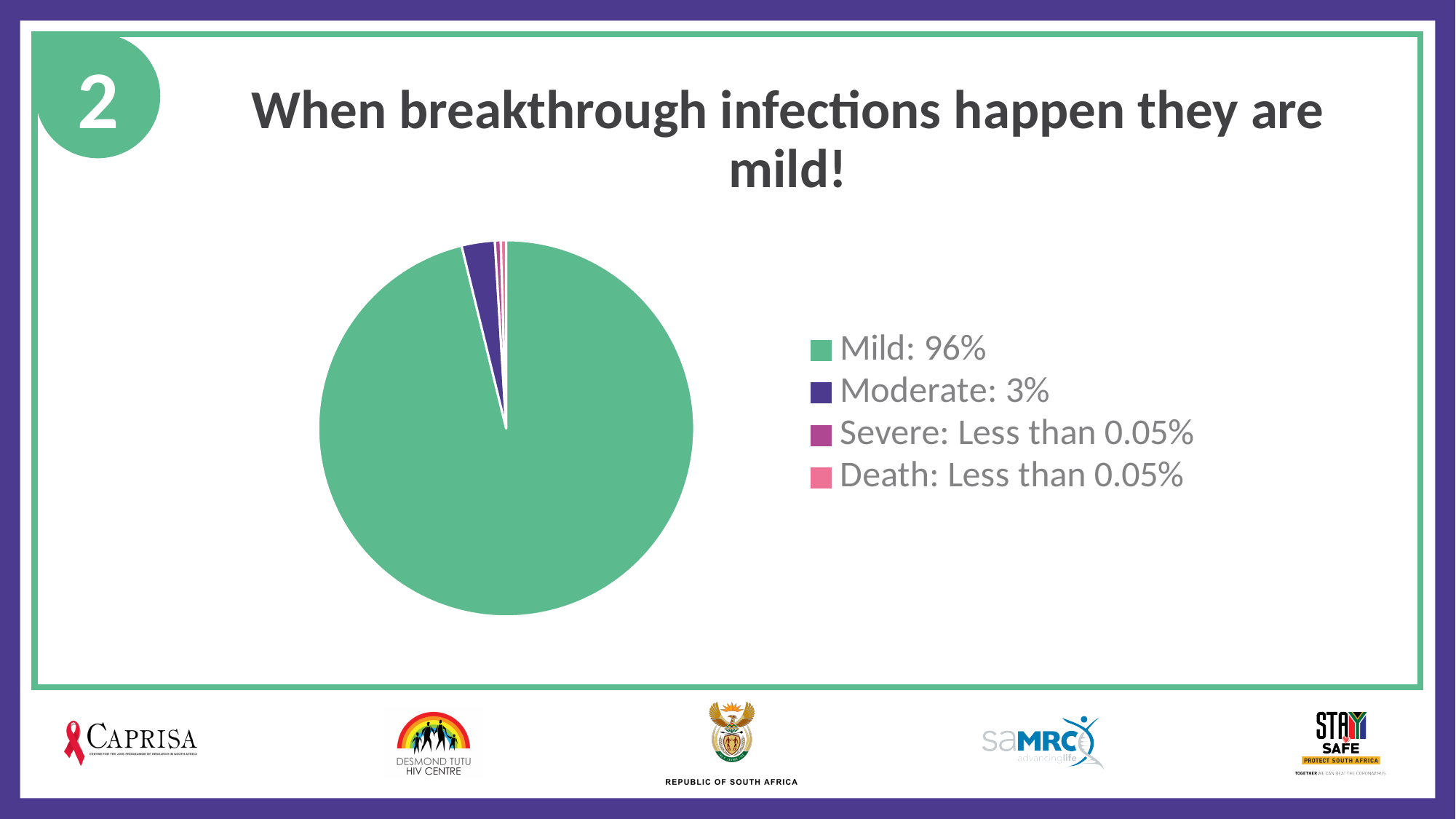
What colour is the Mild slice of the pie? green What is the difference between the Mild and Moderate percentages? 93% What share of breakthrough infections is shown as Mild? 96% What is the title of the slide containing the chart? When breakthrough infections happen they are mild! What share of breakthrough infections is shown as Moderate? 3% What type of chart is shown on the slide? pie chart Which category has the largest slice of the pie? Mild What value does the legend give for Severe? Less than 0.05% What value does the legend give for Death? Less than 0.05% Which is larger, the Mild slice or the Moderate slice? Mild How many categories does the legend list? 4